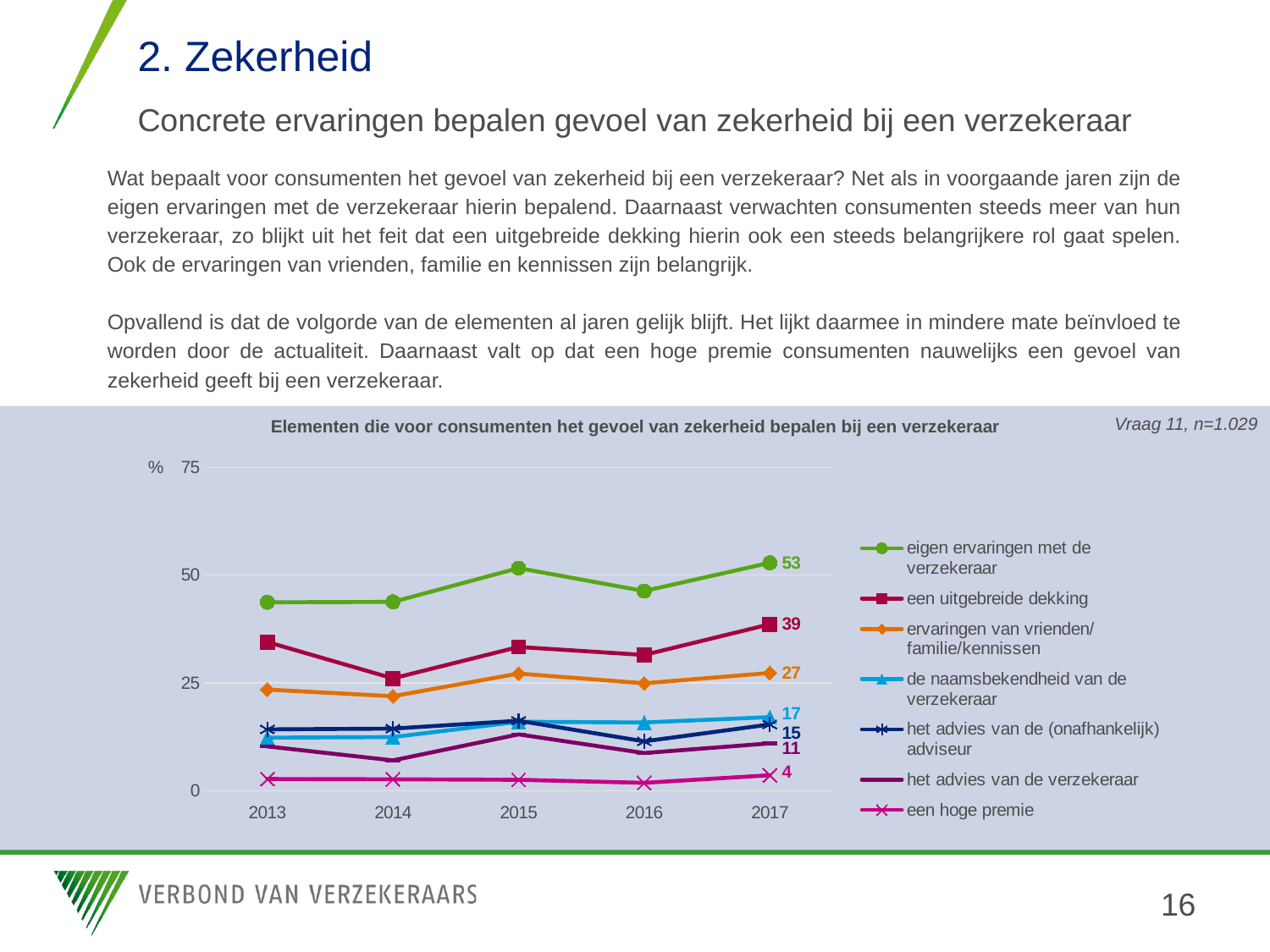
In 2017, which is larger: 'een uitgebreide dekking' or 'ervaringen van vrienden/familie/kennissen'? een uitgebreide dekking What is the value for 'eigen ervaringen met de verzekeraar' in 2017? 53 What is the difference between the 2017 values for 'eigen ervaringen met de verzekeraar' and 'een uitgebreide dekking'? 14 How many years are shown on the x axis? 5 How many series does the legend list? 7 What kind of chart is shown on the slide? line chart Is the value for 'eigen ervaringen met de verzekeraar' in 2013 greater or less than 50? less What is the value for 'een hoge premie' in 2017? 4 Does the value for 'een uitgebreide dekking' rise or fall from 2016 to 2017? rise Which series has the lowest value in 2017? een hoge premie Which series has the highest value in 2017? eigen ervaringen met de verzekeraar What is the value for 'een uitgebreide dekking' in 2017? 39